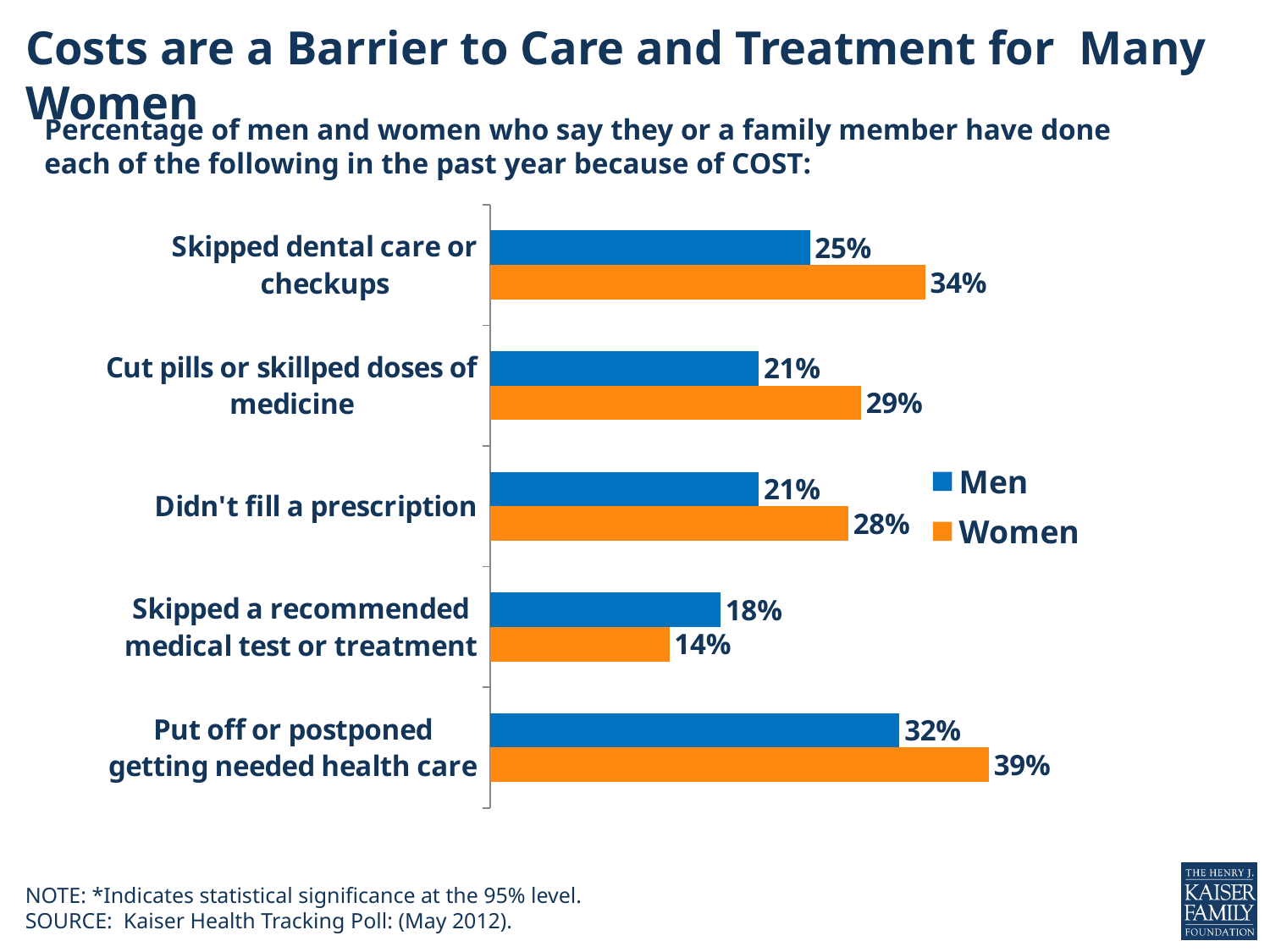
How many series does the legend list? 2 Which category has the highest value for women? Put off or postponed getting needed health care For skipped a recommended medical test or treatment, which is larger, the value for men or for women? Men Which category has the lowest value for men? Skipped a recommended medical test or treatment What percentage of women skipped dental care or checkups because of cost? 34% What is the men's value for didn't fill a prescription? 21% What percentage of women skipped a recommended medical test or treatment because of cost? 14% What kind of chart is shown on the slide? Bar chart How many categories are shown in the chart? 5 What colour represents women in the chart? Orange What is the difference between the women's and men's values for skipped dental care or checkups? 9 percentage points What percentage of men put off or postponed getting needed health care because of cost? 32%